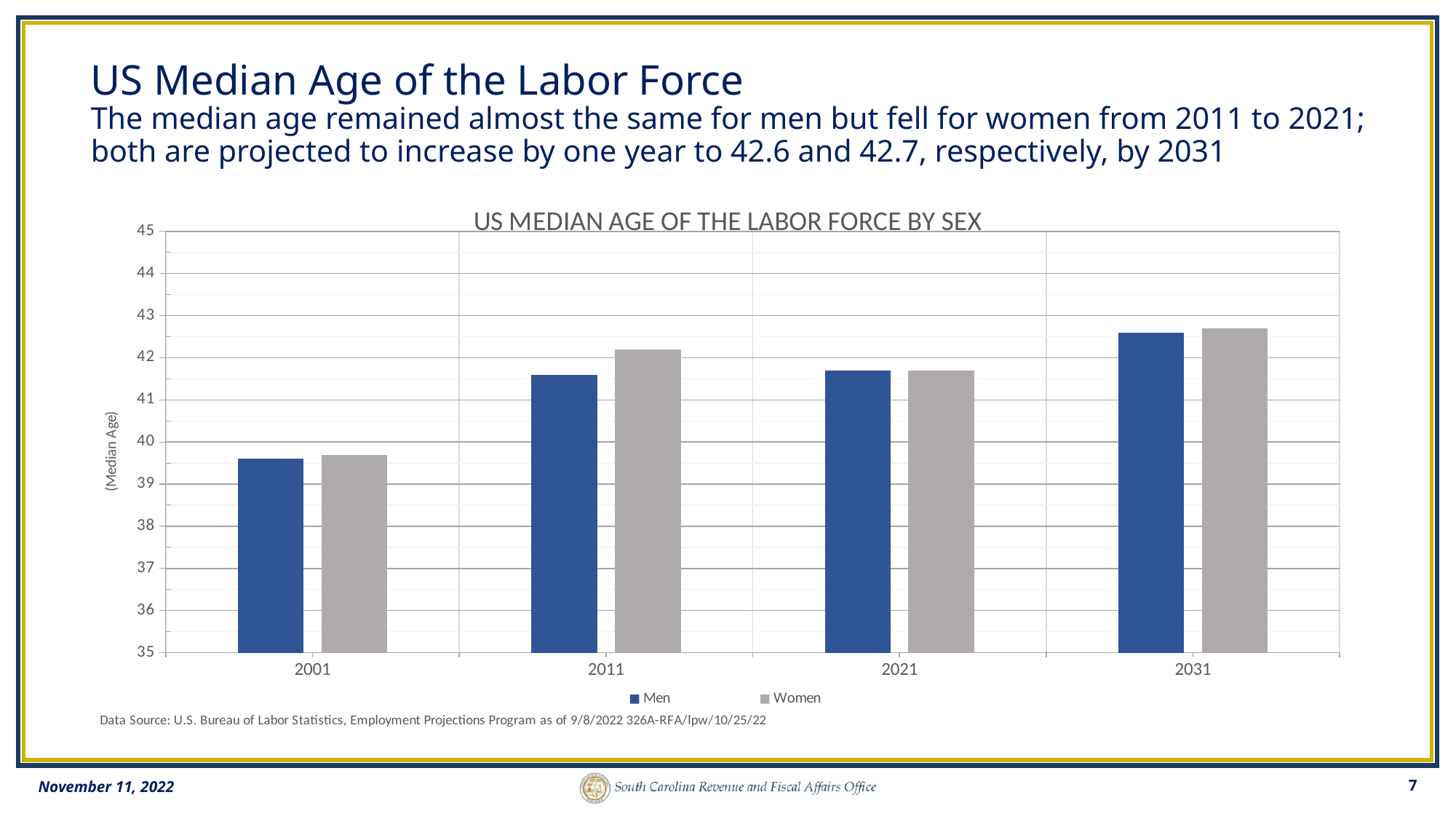
How many series does the legend list in the chart? 2 Which colour represents Women in the chart? gray Is the median age for Men in 2001 greater or less than 40? less Is the median age for Men in 2021 greater or less than 41? greater How many years are shown on the x axis of the chart? 4 Is the median age for Women in 2011 greater or less than 42? greater Which year has the highest median age for Men? 2031 Which year has the lowest median age for Women? 2001 What is the title of the chart? US MEDIAN AGE OF THE LABOR FORCE BY SEX What type of chart is shown on the slide? bar chart Does the median age for Men rise or fall from 2001 to 2031? rise In 2011, which is larger, the median age for Men or for Women? Women